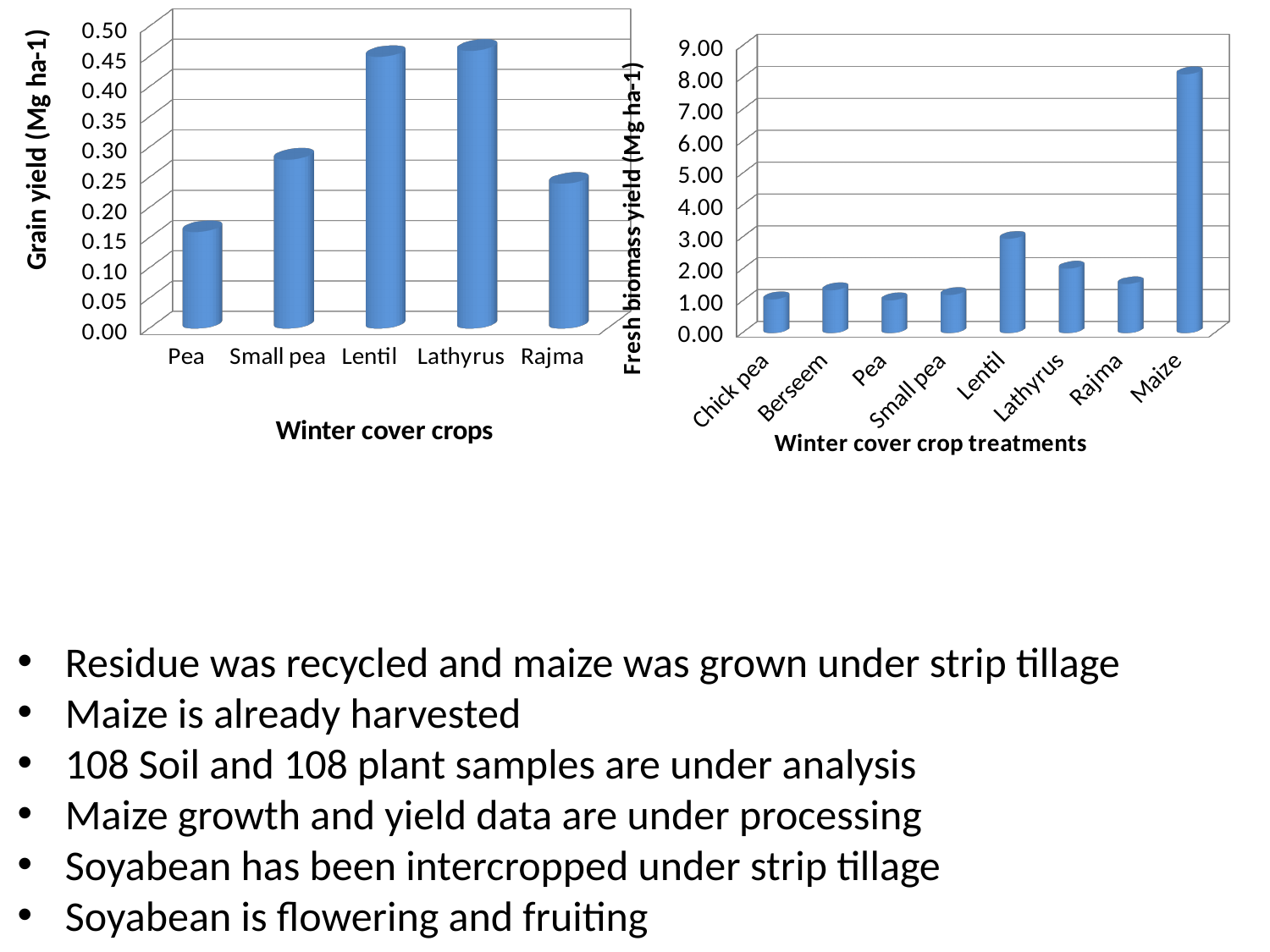
How many winter cover crops are shown in the left chart (Grain yield)? 5 What kind of chart is the left chart (Grain yield)? Bar chart In the left chart (Grain yield), which winter cover crop has the lowest grain yield? Pea In the right chart (Fresh biomass yield), which has the larger value, Lentil or Lathyrus? Lentil In the right chart (Fresh biomass yield), is the value for Maize greater or less than 7.00? greater In the right chart (Fresh biomass yield), is the value for Lentil greater or less than 2.00? greater In the left chart (Grain yield), is the value for Pea greater or less than 0.20? less In the right chart (Fresh biomass yield), which treatment has the highest fresh biomass yield? Maize How many winter cover crop treatments are shown in the right chart (Fresh biomass yield)? 8 What is the y-axis label of the right chart? Fresh biomass yield (Mg ha-1) In the left chart (Grain yield), which has the larger value, Small pea or Rajma? Small pea